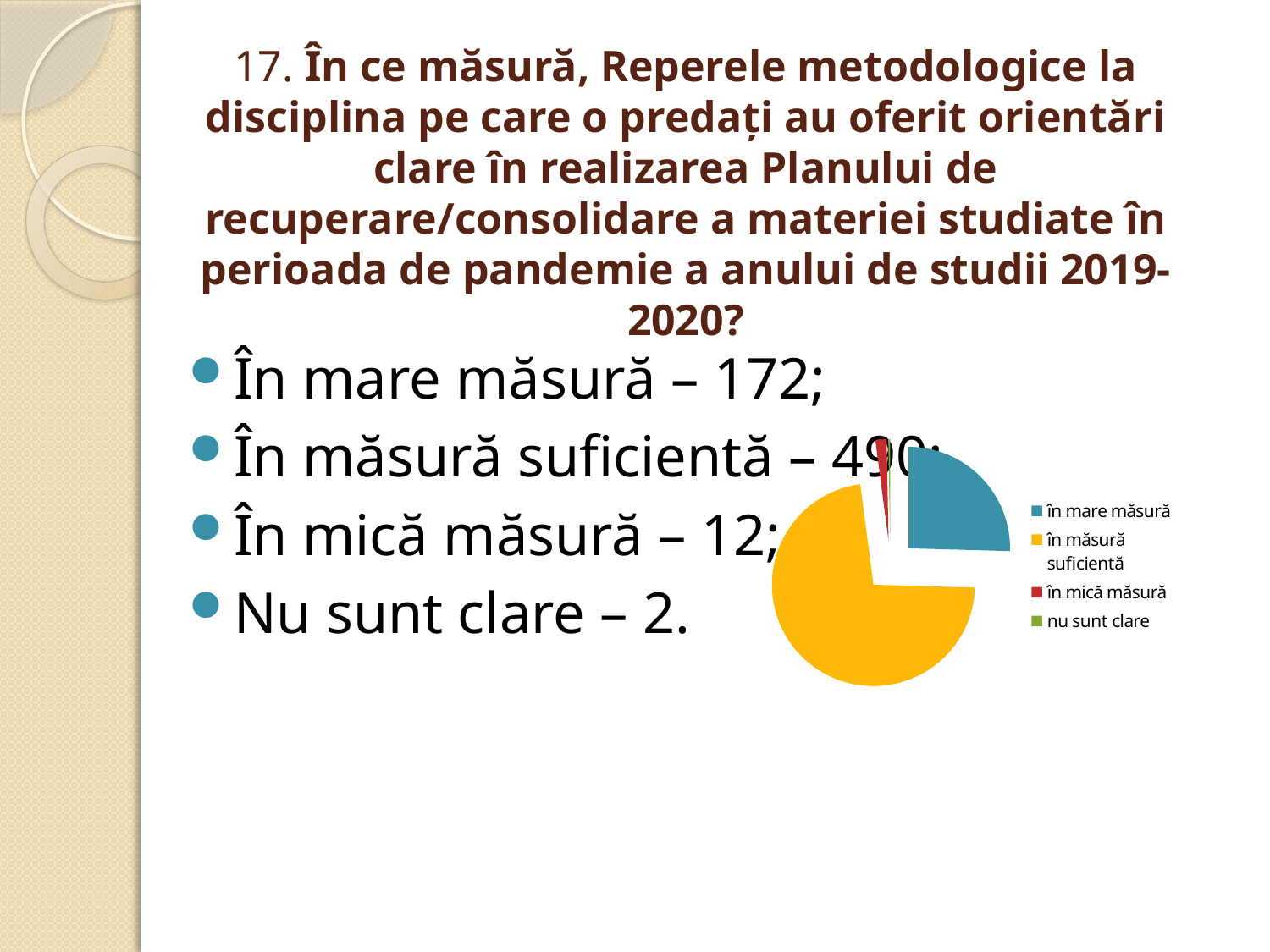
What is the value for Nu sunt clare? 2 What is the difference between the values for În mare măsură and În mică măsură? 160 Which category has the smallest slice in the pie chart? nu sunt clare What kind of chart is shown on the slide? pie chart Which category has the largest slice in the pie chart? în măsură suficientă Which slice is larger in the pie chart: în măsură suficientă or în mare măsură? în măsură suficientă How many categories does the pie chart's legend list? 4 What is the value for În mică măsură? 12 What colour is the în mare măsură slice in the pie chart? teal Which slice is larger in the pie chart: în mare măsură or în mică măsură? în mare măsură What colour is the în măsură suficientă slice in the pie chart? yellow What is the value for În mare măsură? 172